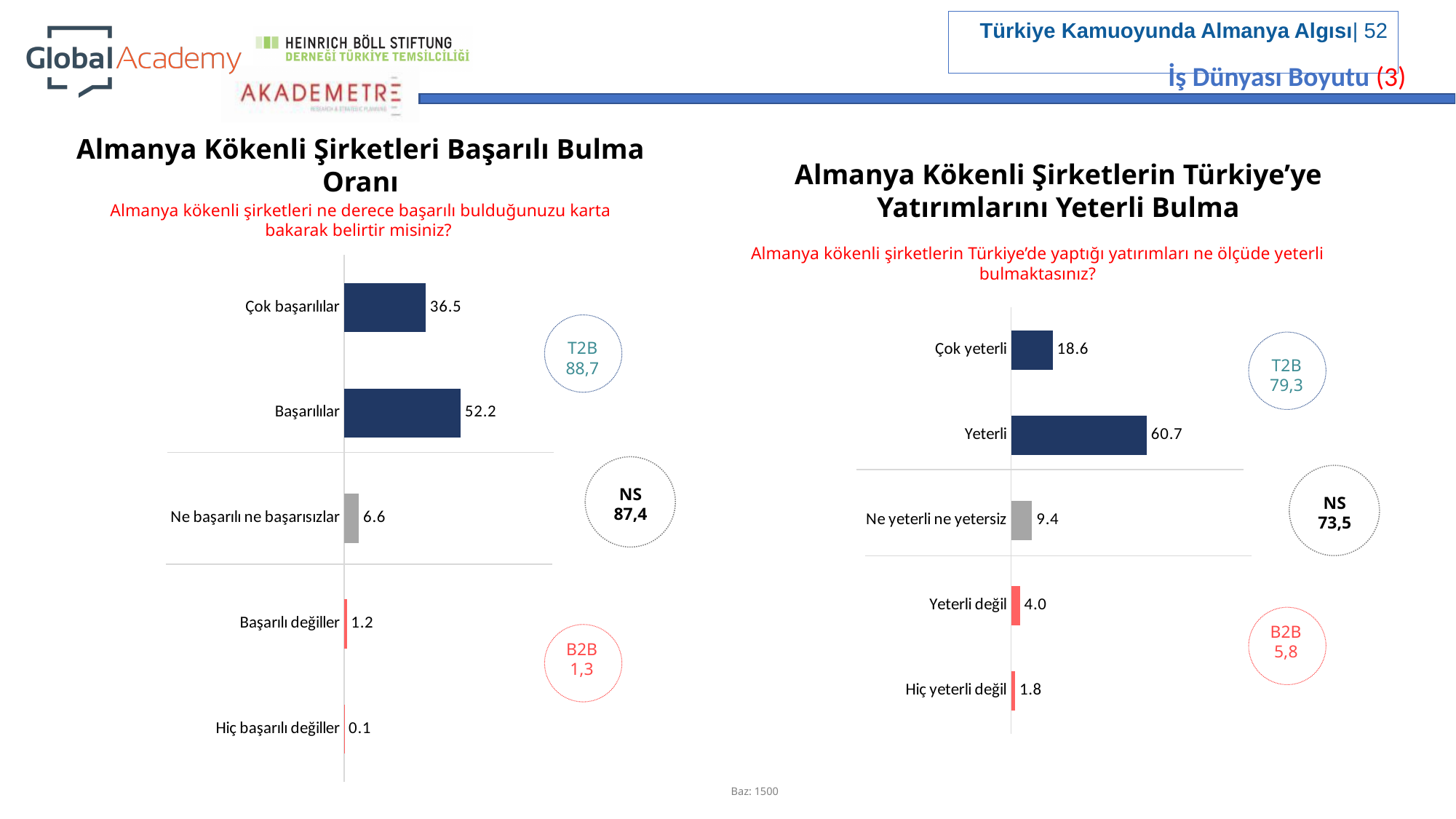
In the left chart 'Almanya Kökenli Şirketleri Başarılı Bulma Oranı', which category has the highest value? Başarılılar In the right chart 'Almanya Kökenli Şirketlerin Türkiye'ye Yatırımlarını Yeterli Bulma', what is the value for 'Yeterli'? 60.7 What kind of chart is the right chart 'Almanya Kökenli Şirketlerin Türkiye'ye Yatırımlarını Yeterli Bulma'? Bar chart In the left chart 'Almanya Kökenli Şirketleri Başarılı Bulma Oranı', what is the value for 'Başarılılar'? 52.2 In the right chart 'Almanya Kökenli Şirketlerin Türkiye'ye Yatırımlarını Yeterli Bulma', what is the value for 'Yeterli değil'? 4.0 In the left chart 'Almanya Kökenli Şirketleri Başarılı Bulma Oranı', what is the value for 'Ne başarılı ne başarısızlar'? 6.6 In the left chart 'Almanya Kökenli Şirketleri Başarılı Bulma Oranı', what is the difference between 'Başarılılar' and 'Çok başarılılar'? 15.7 In the right chart 'Almanya Kökenli Şirketlerin Türkiye'ye Yatırımlarını Yeterli Bulma', what T2B value is shown in the circle? 79,3 In the left chart 'Almanya Kökenli Şirketleri Başarılı Bulma Oranı', which category has the lowest value? Hiç başarılı değiller In the right chart 'Almanya Kökenli Şirketlerin Türkiye'ye Yatırımlarını Yeterli Bulma', which is larger, 'Çok yeterli' or 'Ne yeterli ne yetersiz'? Çok yeterli In the left chart 'Almanya Kökenli Şirketleri Başarılı Bulma Oranı', how many categories are shown? 5 In the right chart 'Almanya Kökenli Şirketlerin Türkiye'ye Yatırımlarını Yeterli Bulma', what is the difference between 'Yeterli' and 'Çok yeterli'? 42.1